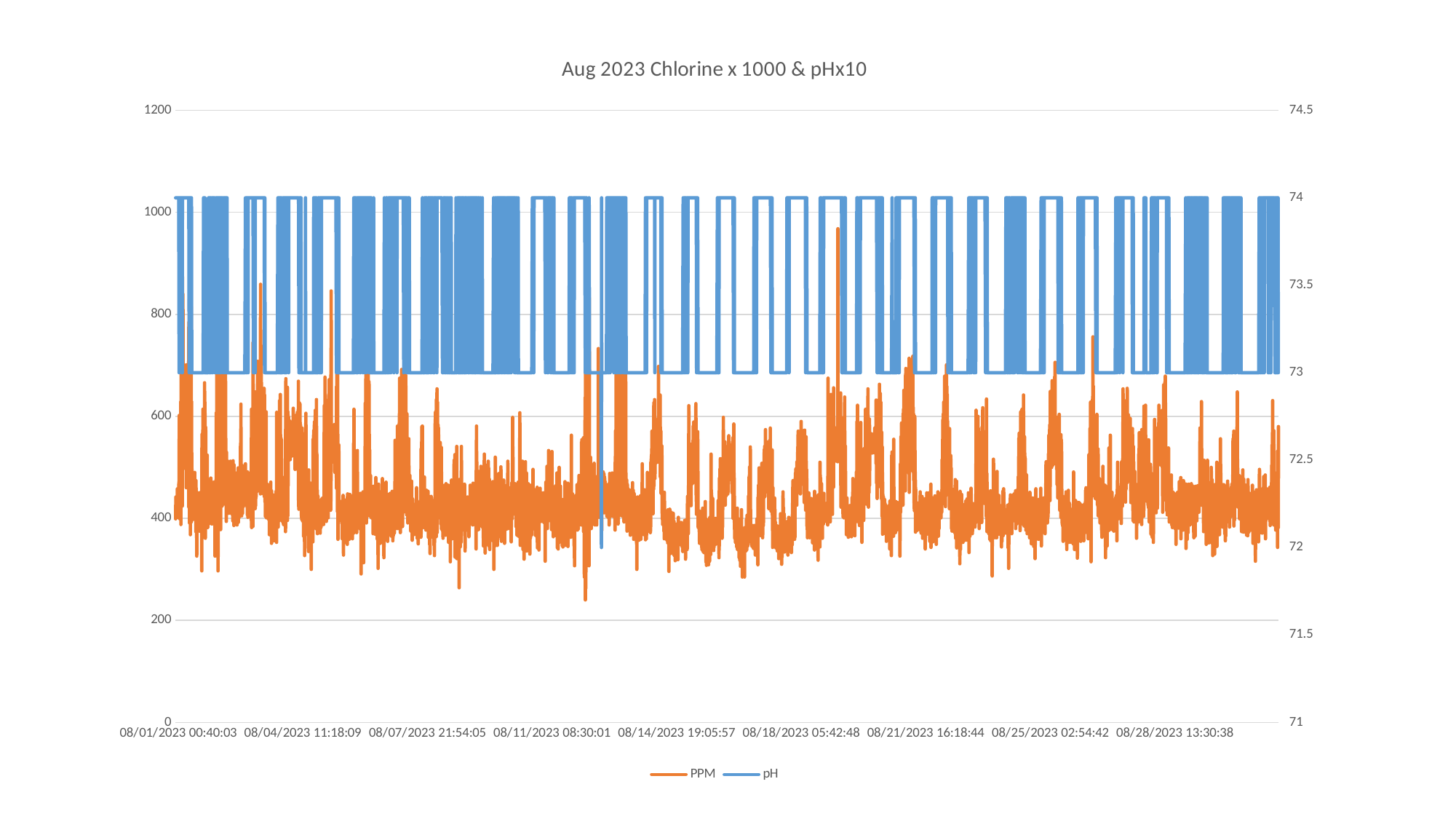
Between which two values on the right axis does the pH line alternate? 73 and 74 What is the title of the chart? Aug 2023 Chlorine x 1000 & pHx10 What is the maximum value shown on the left vertical axis? 1200 Is the highest peak of the PPM series greater or less than 1000? less What is the maximum value shown on the right vertical axis? 74.5 How many date labels are shown along the x axis? 9 Is the lowest dip of the PPM series greater or less than 400? less Is the highest peak of the PPM series greater or less than 800? greater How many series does the legend list? 2 Which series is drawn in blue? pH What kind of chart is shown on the slide? line chart